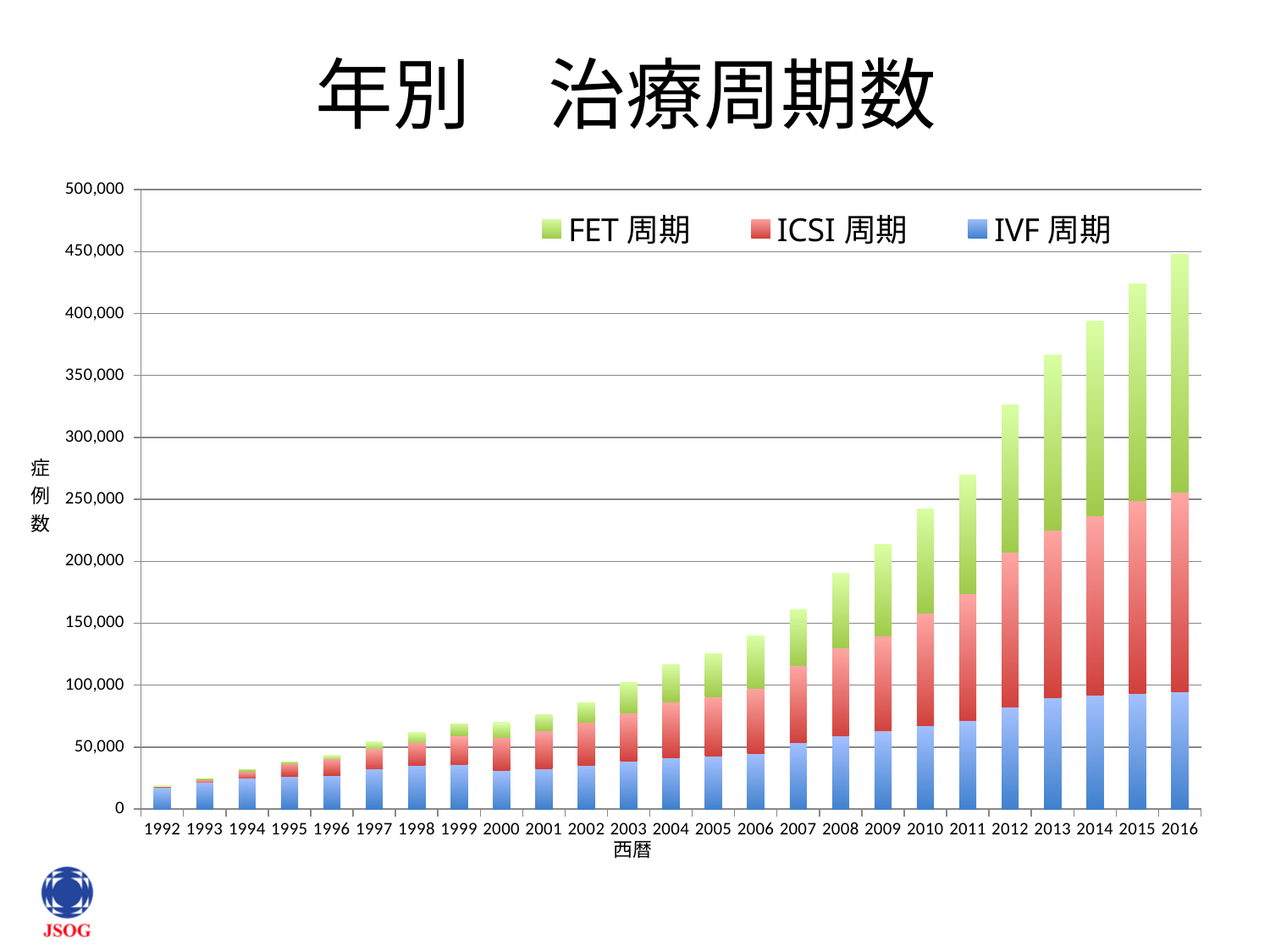
Which year has a larger total, 2010 or 2012? 2012 What kind of chart is shown on the slide? stacked bar chart Do the total treatment cycles generally rise or fall from 1992 to 2016? rise Which year has the lowest total number of treatment cycles? 1992 How many years are shown along the x axis? 25 What is the title of the chart? 年別 治療周期数 Is the total value for 2016 greater or less than 400,000? greater Which year has the highest total number of treatment cycles? 2016 Is the total value for 2011 greater or less than 250,000? greater How many series does the legend list? 3 Is the total value for 2012 greater or less than 300,000? greater Which series is shown in green in the legend? FET 周期